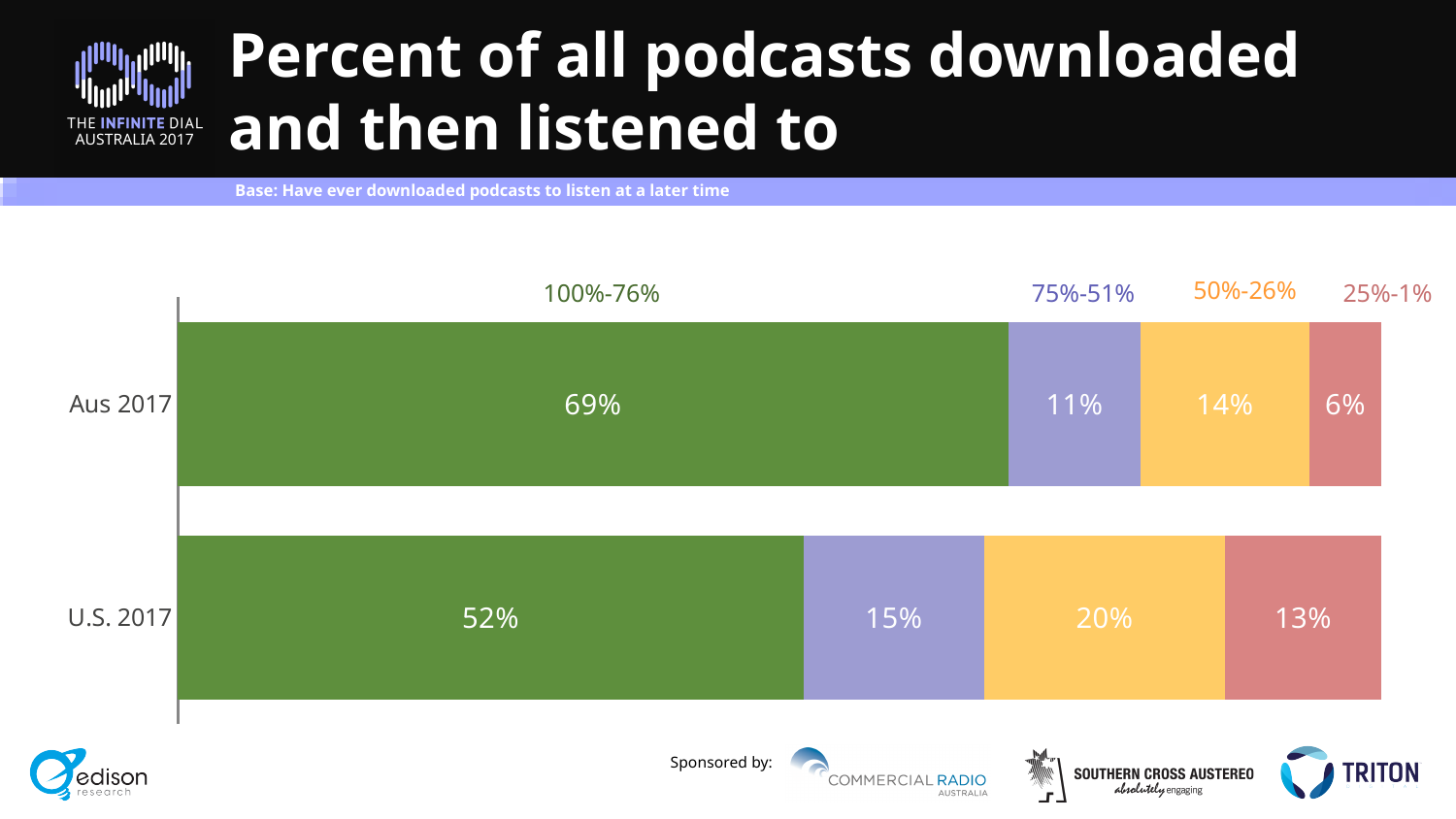
What is the value of the 50%-26% segment for U.S. 2017? 20% Which segment is the largest for U.S. 2017? 100%-76% What is the value of the 25%-1% segment for U.S. 2017? 13% What is the value of the 75%-51% segment for Aus 2017? 11% What is the total of the Aus 2017 stacked bar? 100% Which has a larger 50%-26% segment, Aus 2017 or U.S. 2017? U.S. 2017 How many categories (bars) are shown in the chart? 2 What is the difference between the 100%-76% values for Aus 2017 and U.S. 2017? 17% Which segment is the smallest for Aus 2017? 25%-1% How many series (segments) does the chart show per bar? 4 What percentage of Aus 2017 respondents fall in the 100%-76% segment? 69% What type of chart is shown on the slide? Stacked bar chart